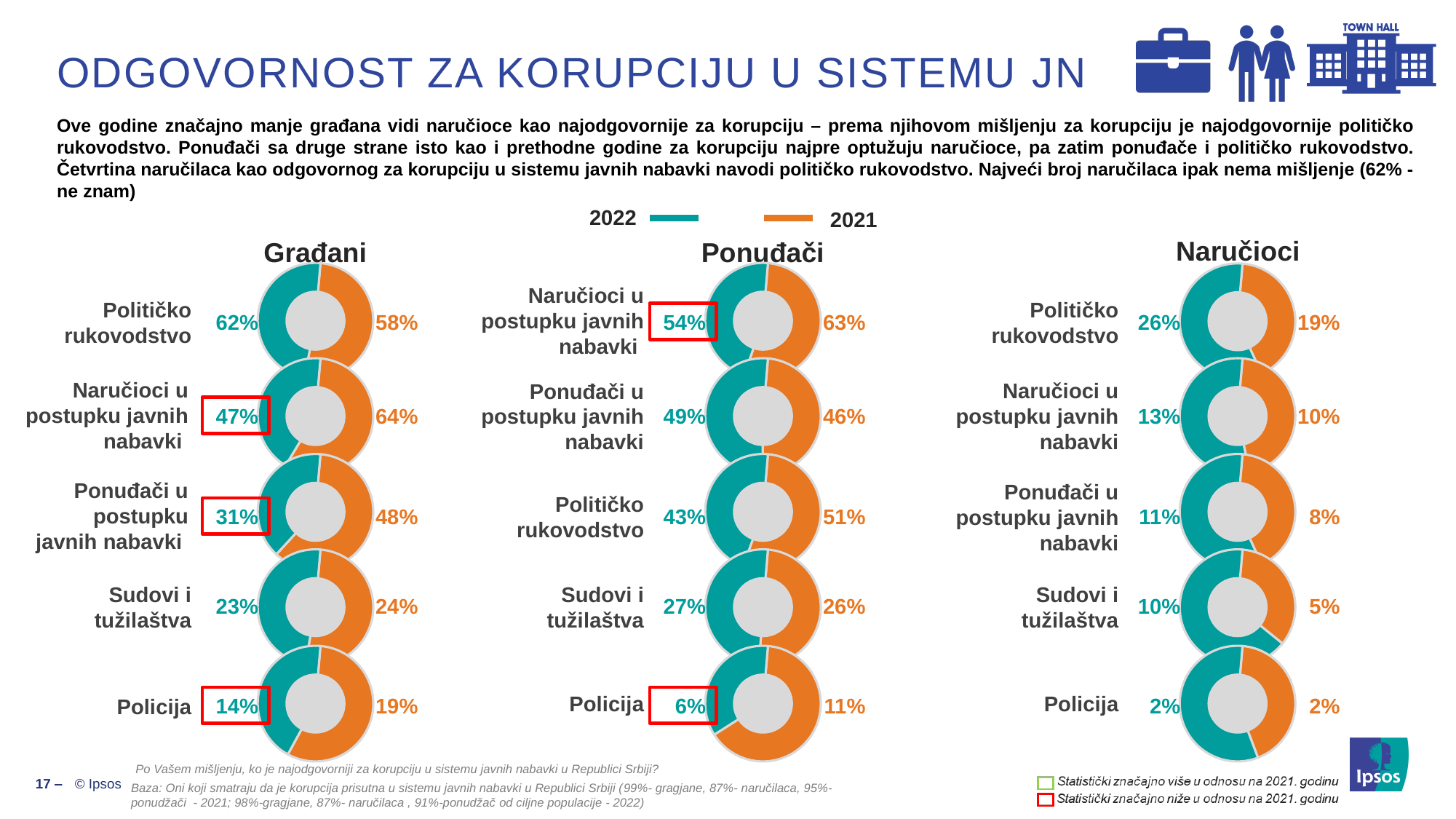
In the Naručioci chart, what is the 2021 value for Sudovi i tužilaštva? 5% In the Ponuđači chart, which is larger for Političko rukovodstvo: the 2022 value or the 2021 value? 2021 In the Građani chart, what is the difference between the 2021 and 2022 values for Ponuđači u postupku javnih nabavki? 17 percentage points Which colour represents 2022 in the legend? Teal In the Građani chart, what is the 2021 value for Naručioci u postupku javnih nabavki? 64% What kind of chart is used to show the values in the Građani section? Donut chart How many series does the legend list? 2 How many categories are shown in the Naručioci chart? 5 In the Naručioci chart, which category has the lowest 2022 value? Policija In the Ponuđači chart, which category has the highest 2021 value? Naručioci u postupku javnih nabavki In the Ponuđači chart, what is the 2022 value for Policija? 6% In the Građani chart, what is the 2022 value for Političko rukovodstvo? 62%